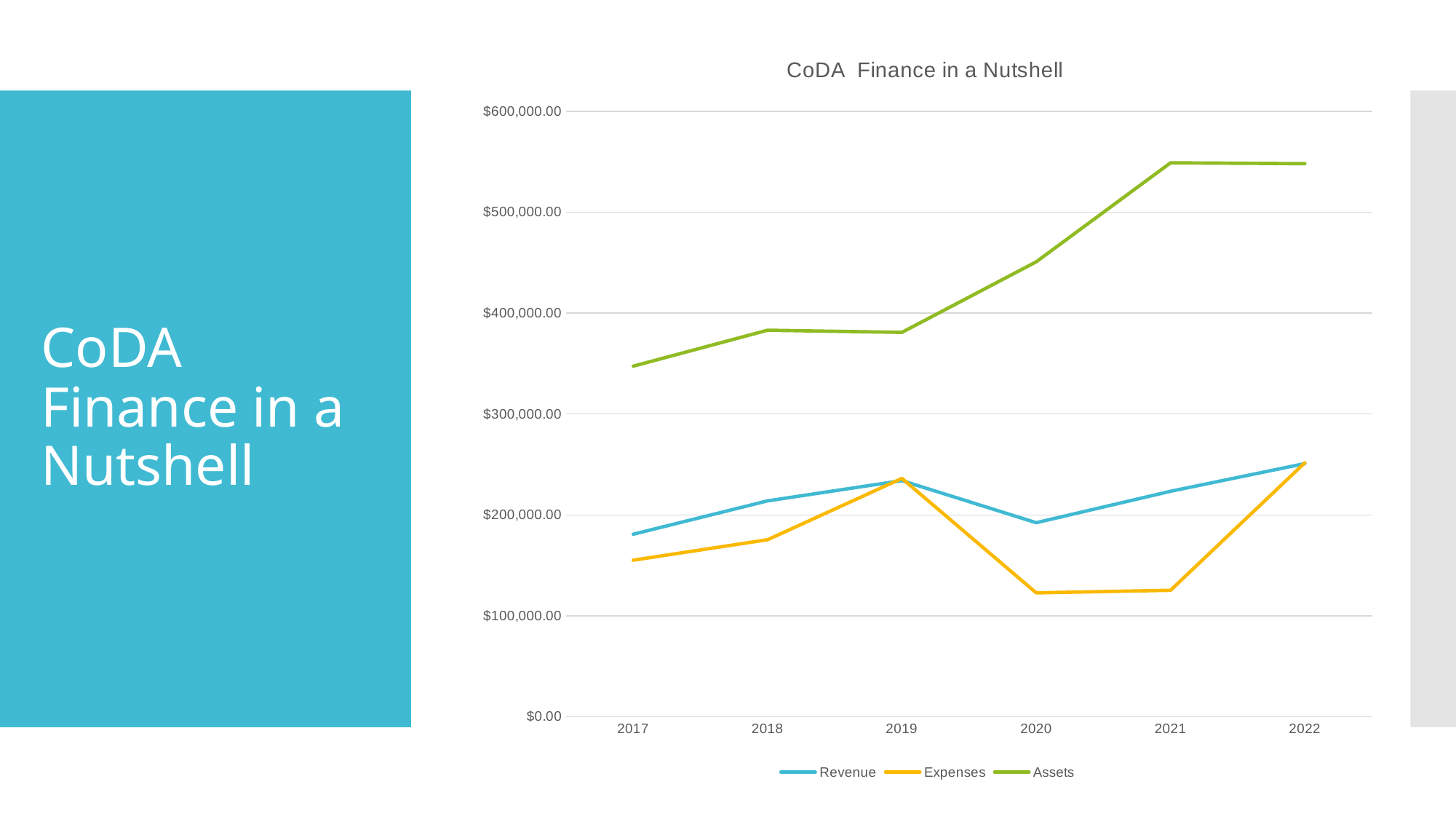
What is the title of the chart? CoDA Finance in a Nutshell What kind of chart is shown on the slide? line chart In 2020, which is larger, Revenue or Expenses? Revenue Is the value for Revenue in 2017 greater or less than $200,000.00? less Is the value for Assets in 2017 greater or less than $300,000.00? greater In which year are Assets lowest? 2017 Is the value for Expenses in 2020 greater or less than $200,000.00? less Do Assets rise or fall overall from 2017 to 2022? rise How many series does the legend list? 3 How many years are plotted along the x axis? 6 In which year are Expenses highest? 2022